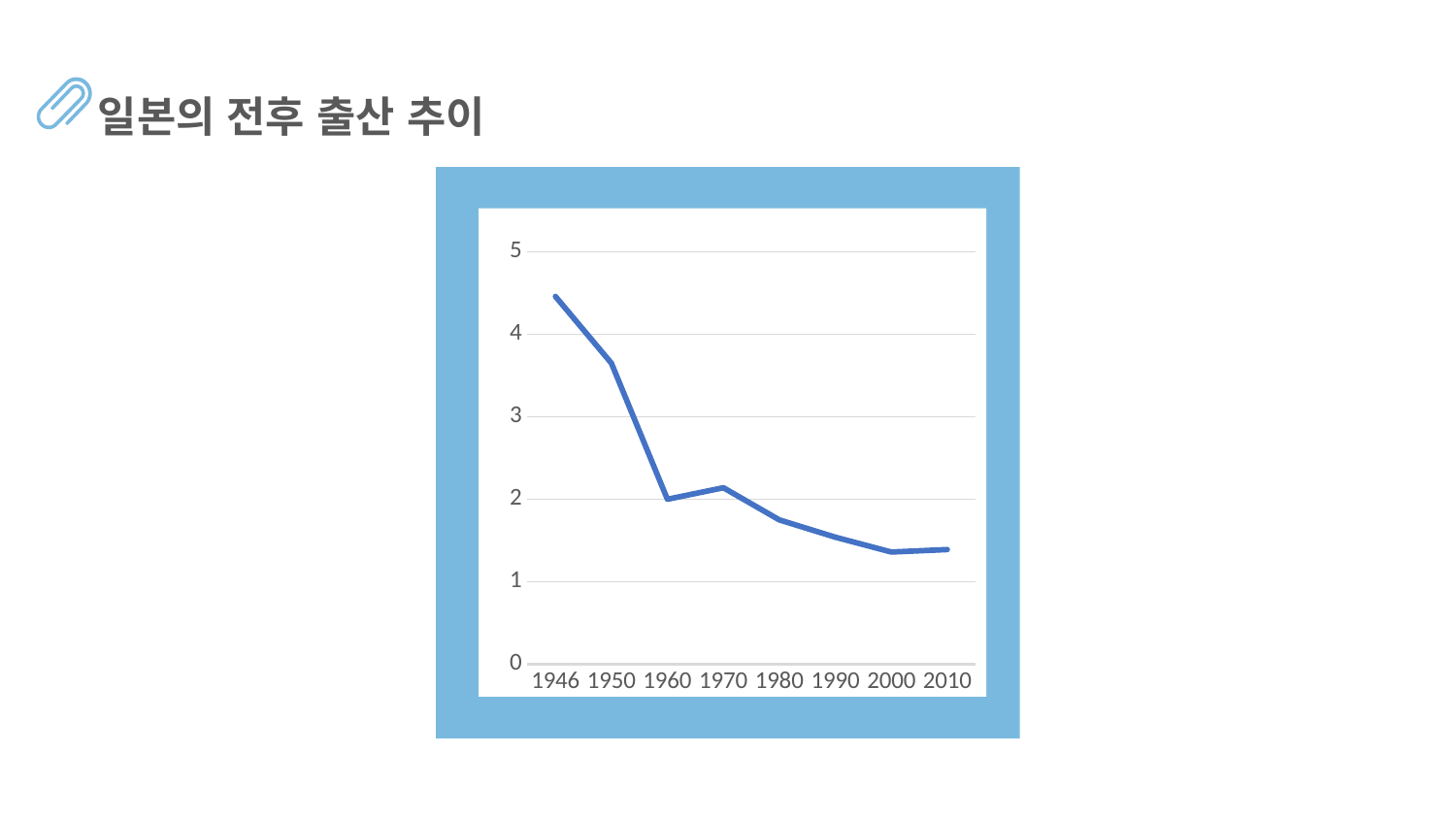
What kind of chart is shown on the slide? line chart How many data points are plotted on the line? 8 Is the value for 2010 greater or less than 1? greater Which is larger, the value for 1946 or the value for 1950? 1946 Overall, do the values rise or fall from 1946 to 2010? fall Which year has the highest value on the chart? 1946 Is the value for 1946 greater or less than 4? greater Is the value for 1980 greater or less than 2? less Which is larger, the value for 1950 or the value for 1980? 1950 What is the title of the slide containing the chart? 일본의 전후 출산 추이